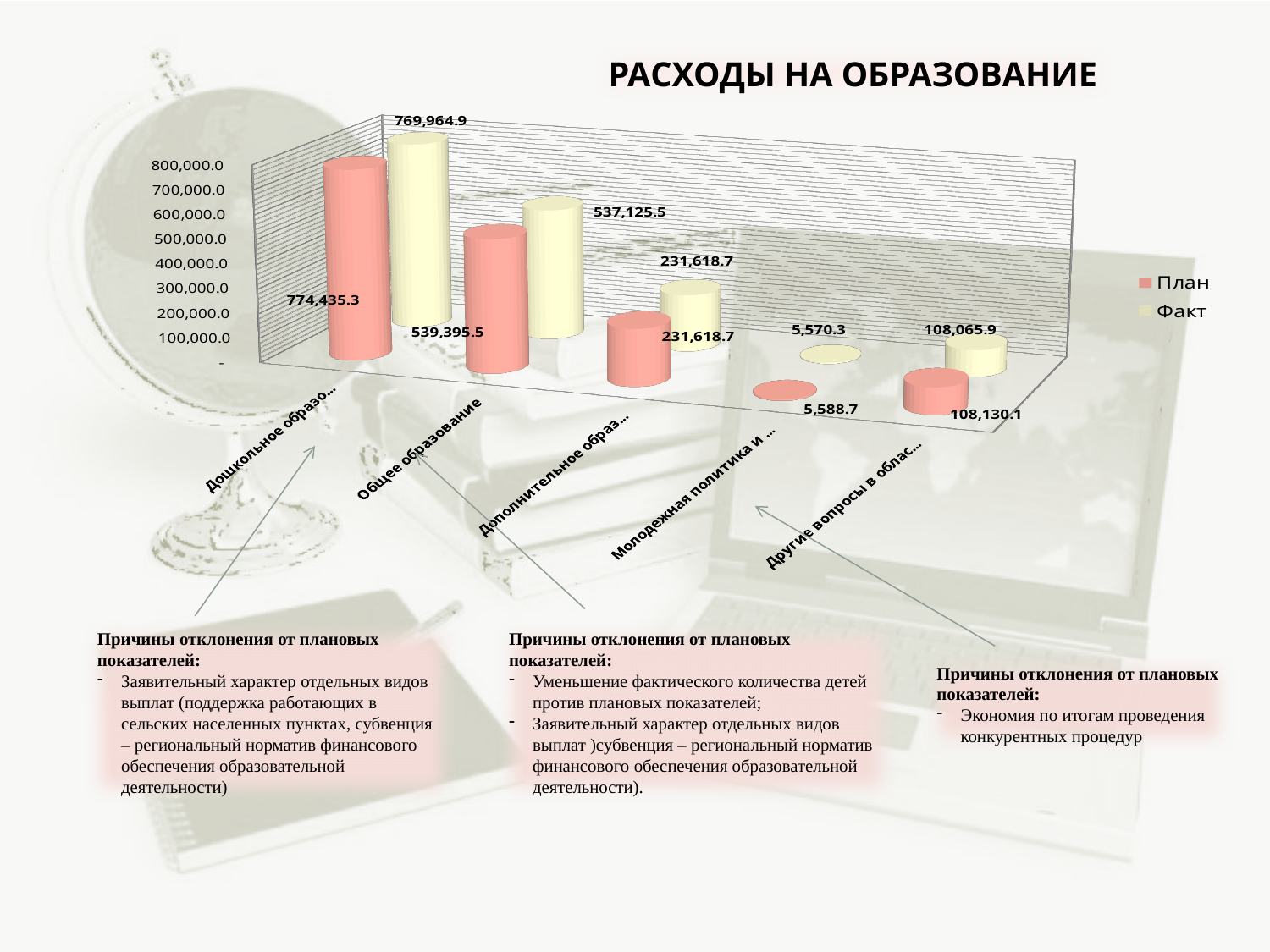
What is the difference between the План and Факт values for Общее образование? 2,270.0 What is the План value for Общее образование? 539,395.5 What is the title of the chart? РАСХОДЫ НА ОБРАЗОВАНИЕ How many series does the chart legend list? 2 Which category has the highest План value? Дошкольное образо… (the first category) For Общее образование, which is larger: the План value or the Факт value? План What kind of chart is shown on the slide? bar chart Which category has the lowest Факт value? Молодежная политика и … (the fourth category) How many categories are shown on the x axis of the chart? 5 Is the План value for Общее образование greater or less than 500,000.0? greater What are the two series named in the chart legend? План and Факт What is the Факт value for Общее образование? 537,125.5